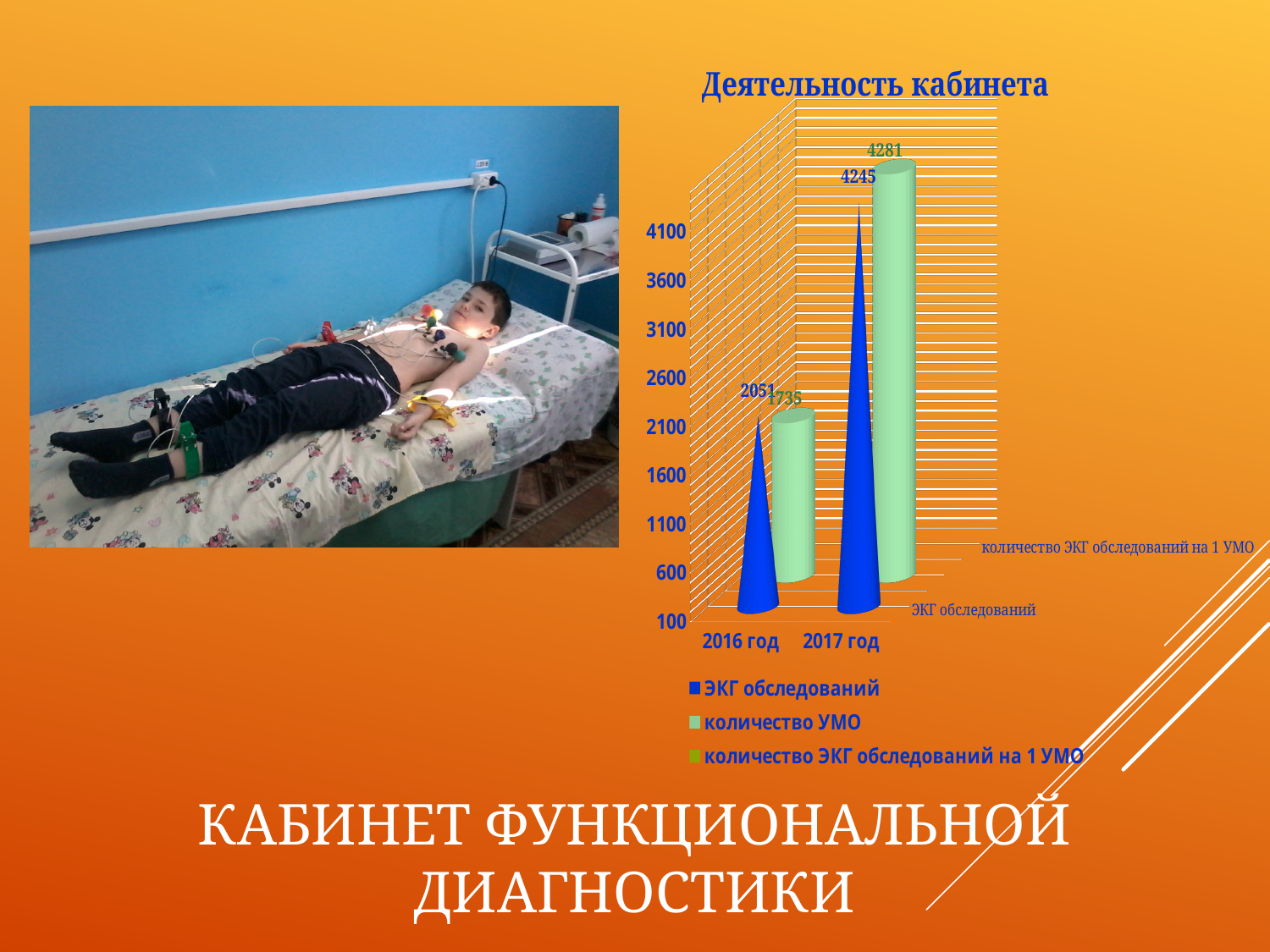
What is the value of ЭКГ обследований for 2016 год? 2051 How many year categories are shown on the x axis of the chart? 2 What type of chart is shown on the slide? bar chart Which year has the higher value of ЭКГ обследований? 2017 год What is the value of ЭКГ обследований for 2017 год? 4245 What is the difference between количество УМО in 2017 год and 2016 год? 2546 What is the value of количество УМО for 2016 год? 1735 What is the value of количество УМО for 2017 год? 4281 How many series does the chart legend list? 3 By how much did ЭКГ обследований increase from 2016 год to 2017 год? 2194 Does the value of ЭКГ обследований rise or fall from 2016 год to 2017 год? rise What is the title of the chart on the slide? Деятельность кабинета